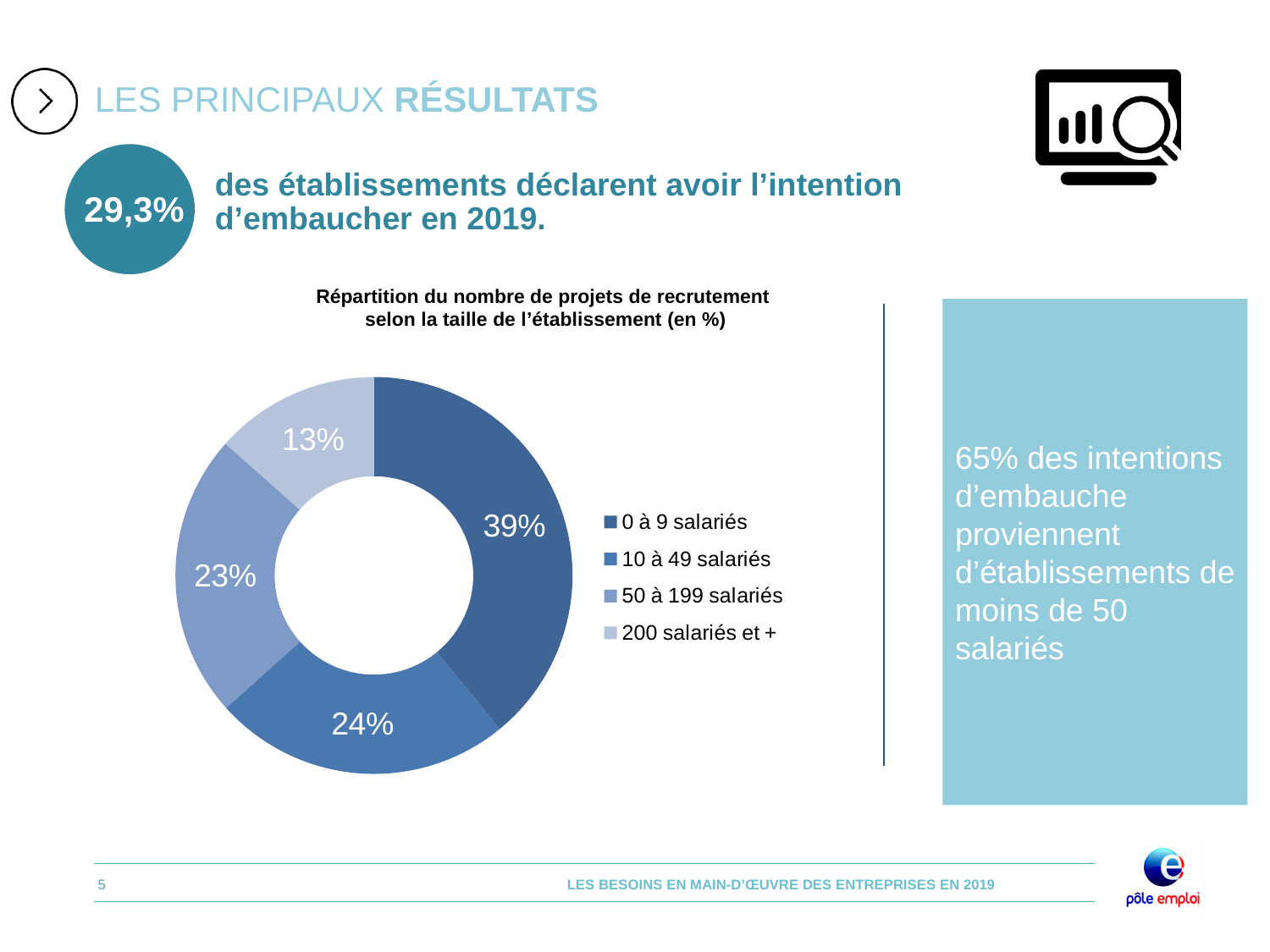
What share of recruitment projects comes from establishments with 10 à 49 salariés? 24% How many categories does the legend of the chart list? 4 What share of recruitment projects comes from establishments with 0 à 9 salariés? 39% What is the difference in percentage points between the share for 0 à 9 salariés and the share for 200 salariés et +? 26 What share of recruitment projects comes from establishments with 200 salariés et +? 13% What is the title of the chart? Répartition du nombre de projets de recrutement selon la taille de l'établissement (en %) Which has a larger share: 0 à 9 salariés or 50 à 199 salariés? 0 à 9 salariés Which establishment size category has the largest share of recruitment projects? 0 à 9 salariés What kind of chart is shown on the slide? Pie chart (donut) Which establishment size category has the smallest share of recruitment projects? 200 salariés et + What is the combined share of the 0 à 9 salariés and 10 à 49 salariés slices? 63% What share of recruitment projects comes from establishments with 50 à 199 salariés? 23%